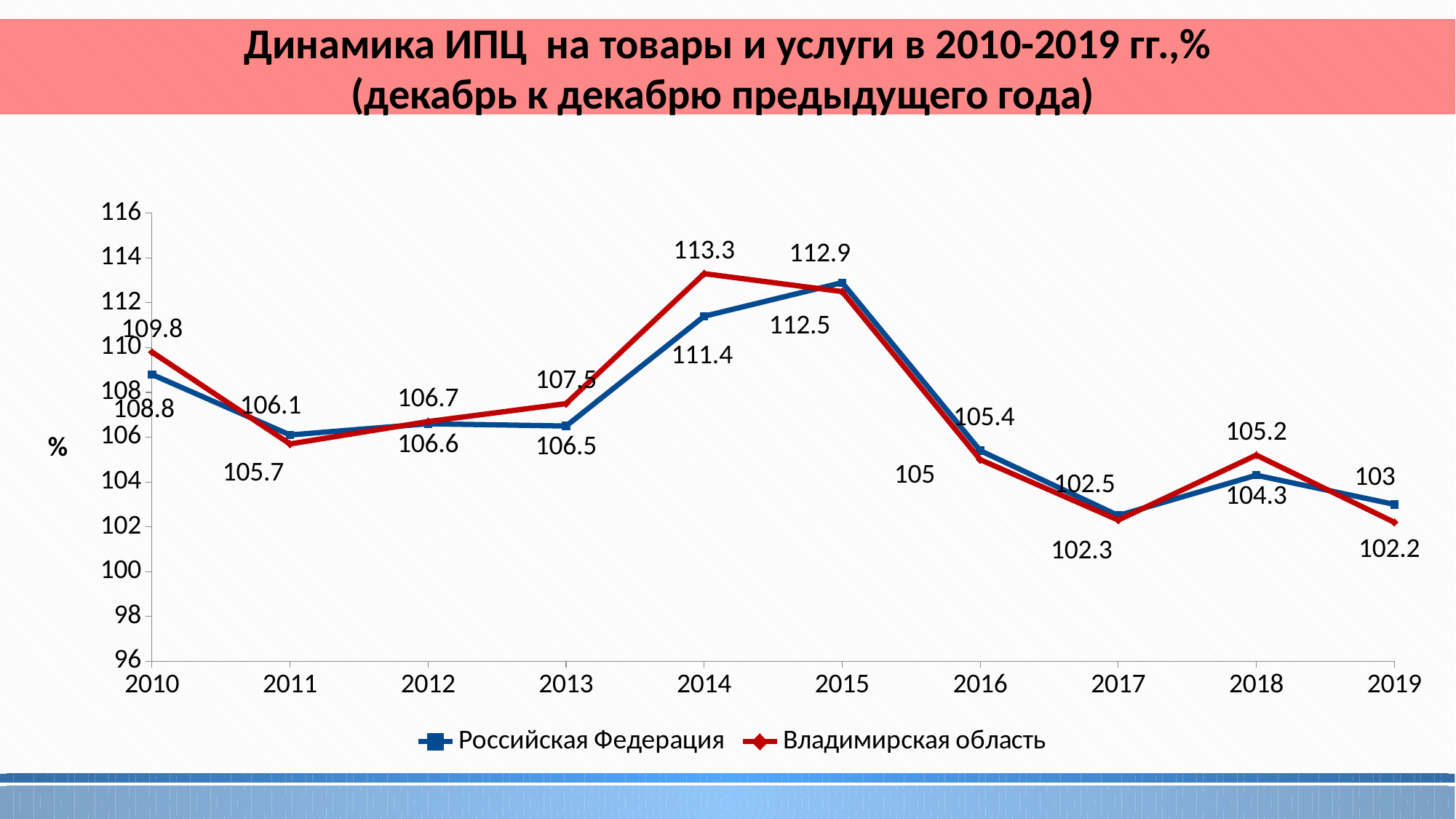
In which year does Владимирская область have its lowest value? 2019 In which year does Владимирская область reach its highest value? 2014 In 2018, which series has the larger value, Российская Федерация or Владимирская область? Владимирская область What is the value for Российская Федерация in 2014? 111.4 How many series does the legend list? 2 In which year does Российская Федерация reach its highest value? 2015 What is the difference between Владимирская область and Российская Федерация in 2014? 1.9 How many years are plotted along the x axis? 10 What is the value for Российская Федерация in 2019? 103 What is the value for Владимирская область in 2014? 113.3 What type of chart is shown on the slide? Line chart Do the values for Российская Федерация rise or fall from 2015 to 2017? Fall